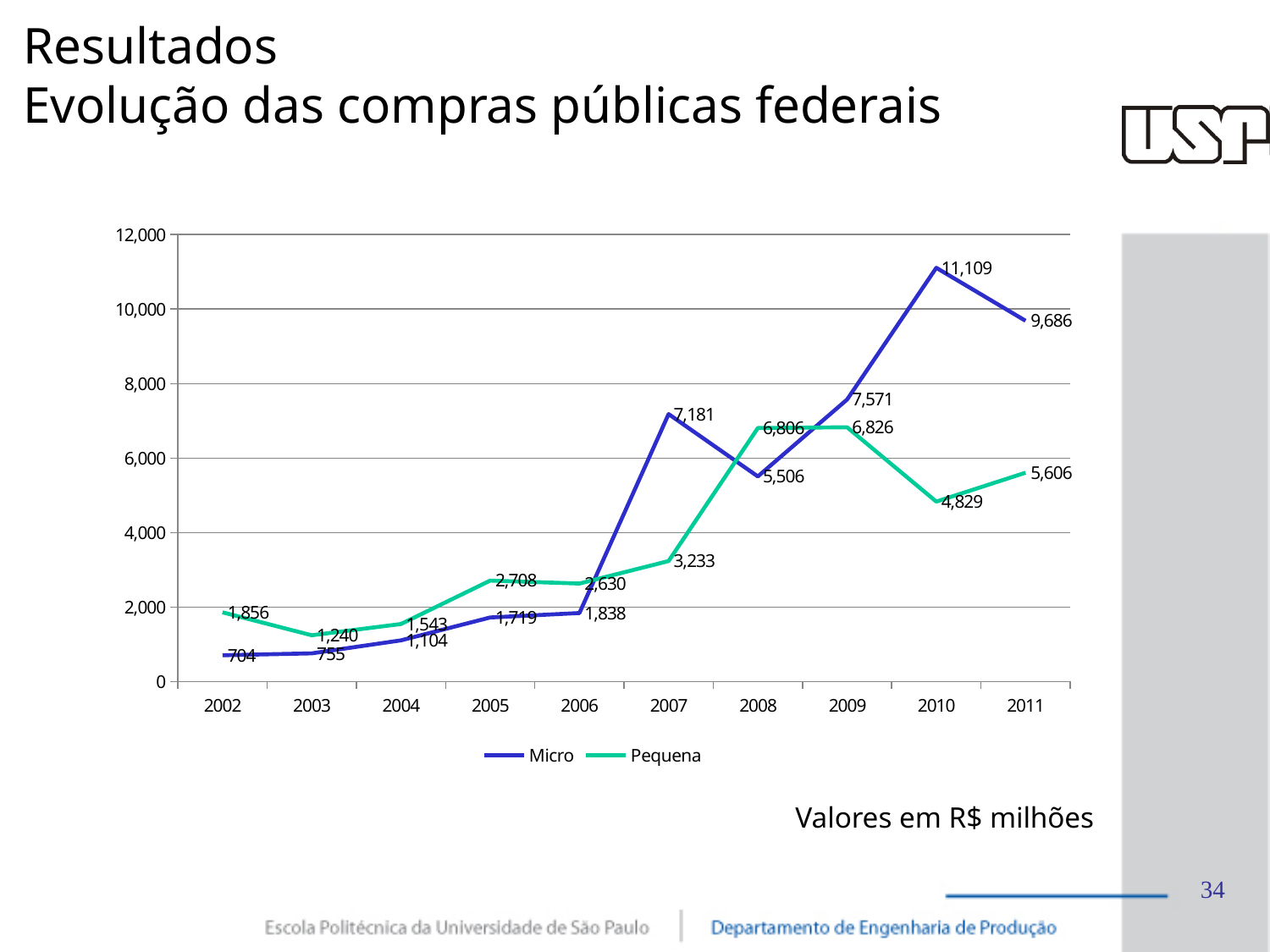
How many series does the legend list? 2 What is the value for Micro in 2010? 11,109 What is the difference between the Micro values for 2010 and 2011? 1,423 In which year does the Pequena series have its lowest value? 2003 How many years are shown on the x axis? 10 In which year does the Micro series reach its highest value? 2010 What is the value for Pequena in 2008? 6,806 In 2007, which series has the larger value, Micro or Pequena? Micro Does the Micro series rise or fall from 2002 to 2006? Rise In which year does the Micro series have its lowest value? 2002 What kind of chart is shown on the slide? Line chart What is the value for Pequena in 2011? 5,606